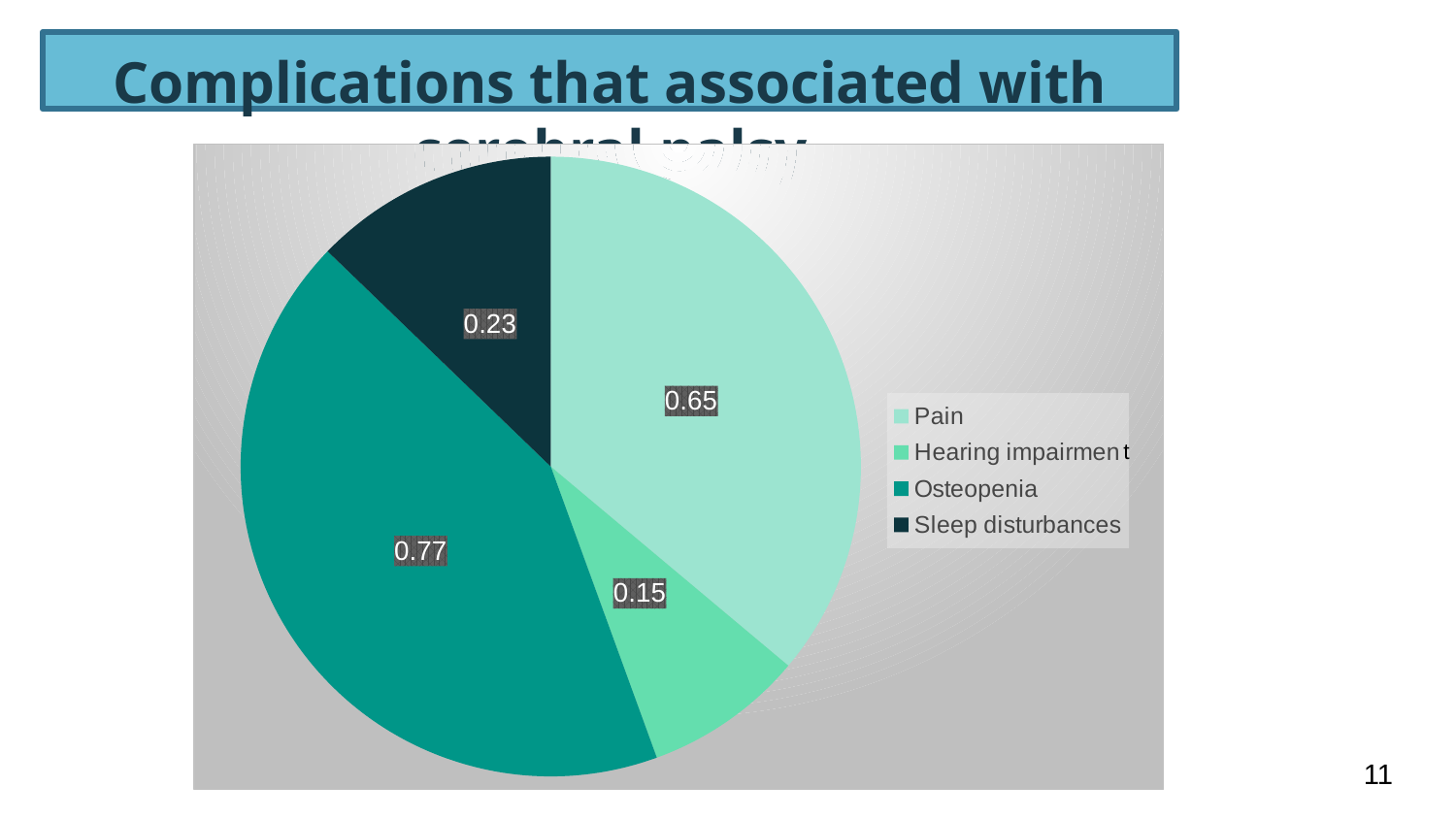
What is the value shown for Sleep disturbances? 0.23 What is the value shown for Pain? 0.65 Which complication has the smallest slice of the pie? Hearing impairment Which complication has the largest slice of the pie? Osteopenia What is the value shown for Osteopenia? 0.77 What is the difference between the values for Osteopenia and Pain? 0.12 What kind of chart is shown on the slide? pie chart How many slices does the pie chart have? 4 Which is larger, the value for Pain or the value for Sleep disturbances? Pain Which complication is shown in the darkest colour on the pie chart? Sleep disturbances What is the value shown for Hearing impairment? 0.15 What is the difference between the values for Sleep disturbances and Hearing impairment? 0.08